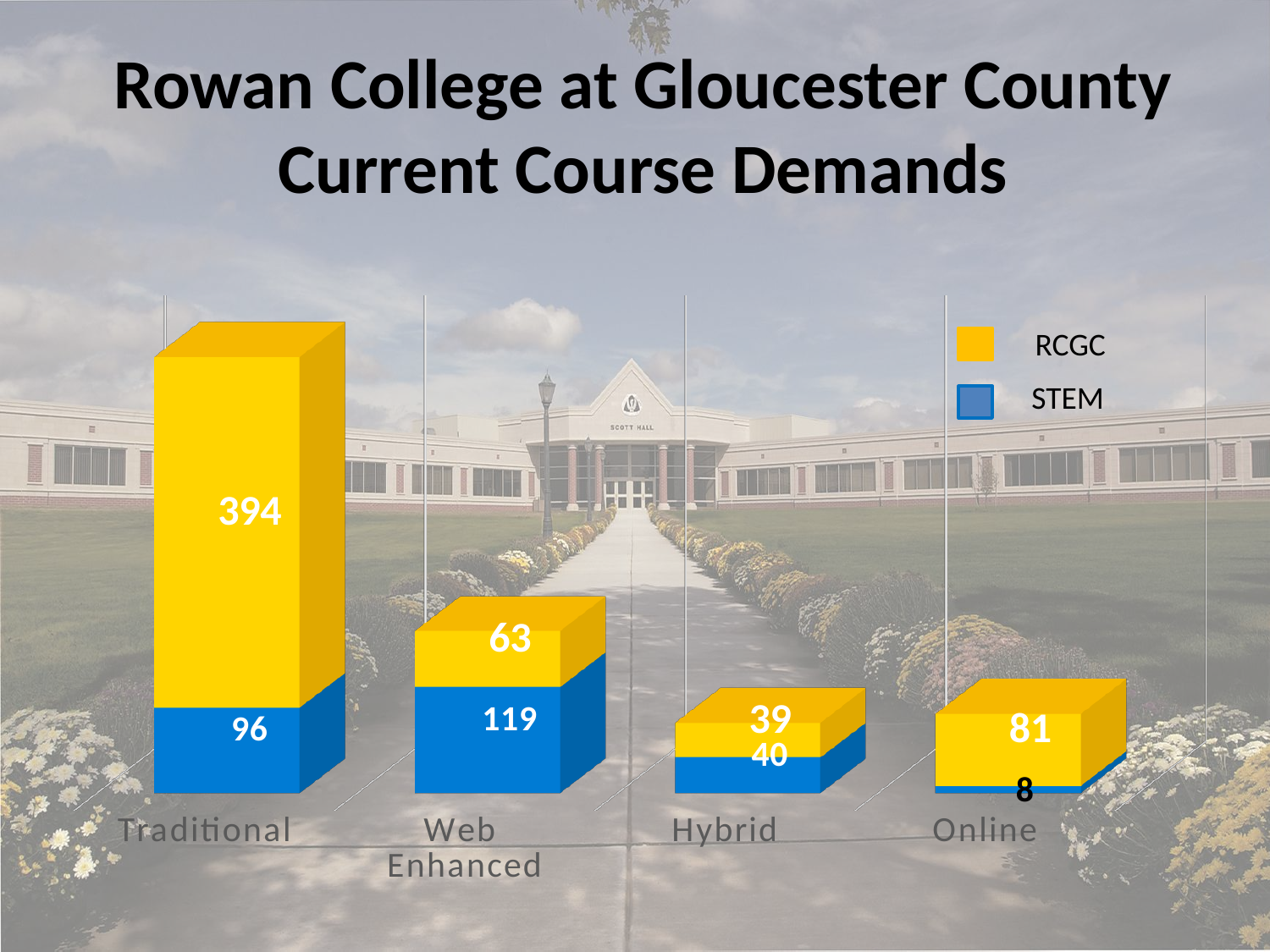
What is the STEM value for Online courses? 8 What is the difference between the RCGC and STEM values for Traditional courses? 298 How many categories are shown on the x axis? 4 What is the STEM value for Web Enhanced courses? 119 Which category has the lowest STEM value? Online Which is larger for Web Enhanced courses, the RCGC value or the STEM value? STEM What is the RCGC value for Hybrid courses? 39 What is the RCGC value for Traditional courses? 394 What is the total of the stacked bar for Web Enhanced courses? 182 How many series does the legend list? 2 What kind of chart is shown on the slide? Stacked bar chart Which category has the highest RCGC value? Traditional